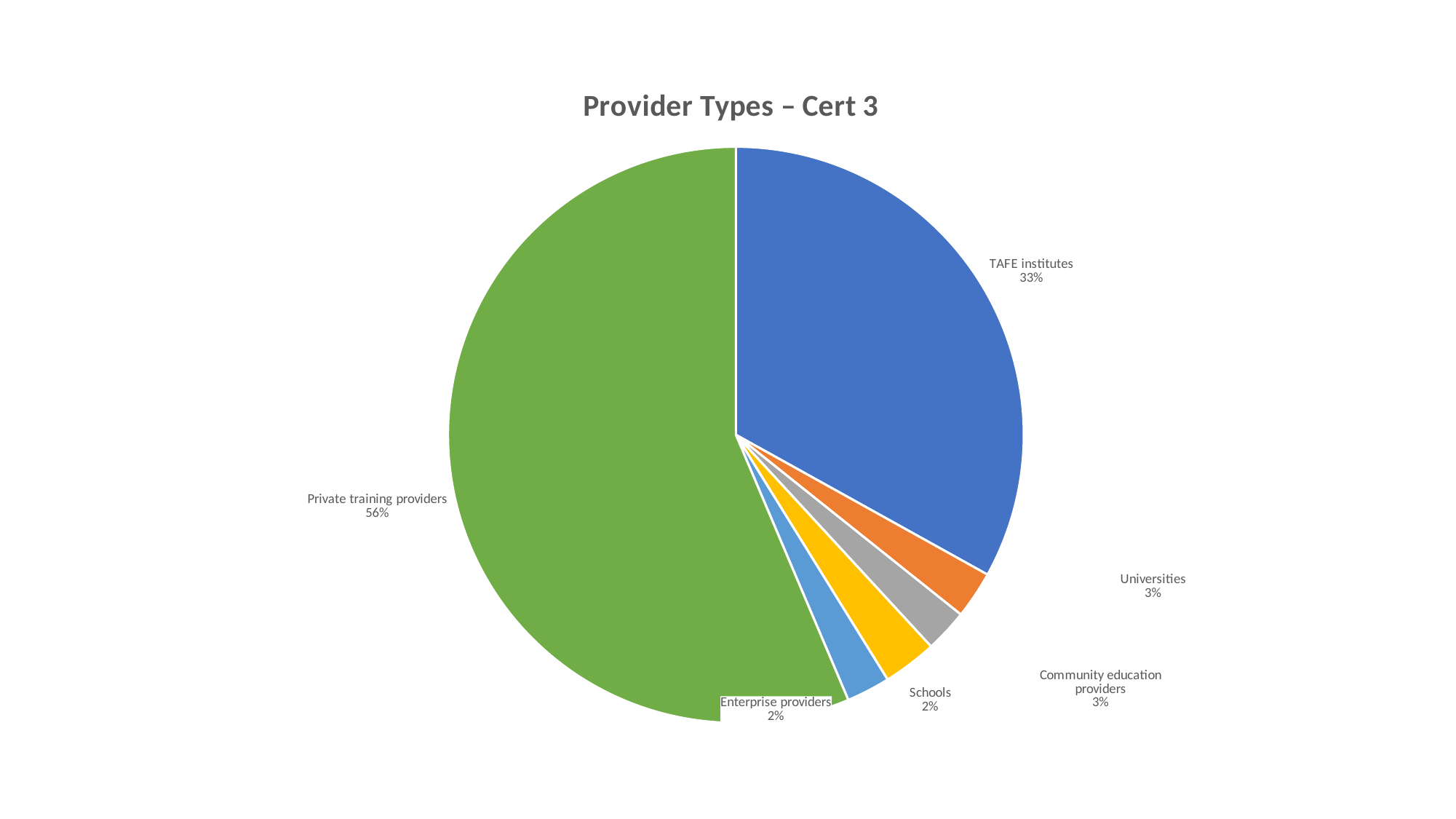
What percentage is shown for Community education providers? 3% How many slices does the pie chart have? 6 What type of chart is shown on the slide? pie chart What is the title of the chart? Provider Types – Cert 3 What share of the pie do Private training providers account for? 56% What is the difference in percentage points between Private training providers and TAFE institutes? 23 What percentage is shown for Schools? 2% Which provider type has the largest slice of the pie? Private training providers What percentage is shown for Universities? 3% What share of the pie do TAFE institutes account for? 33% What colour is the slice for Private training providers? green Which is larger, the share for TAFE institutes or the share for Universities? TAFE institutes